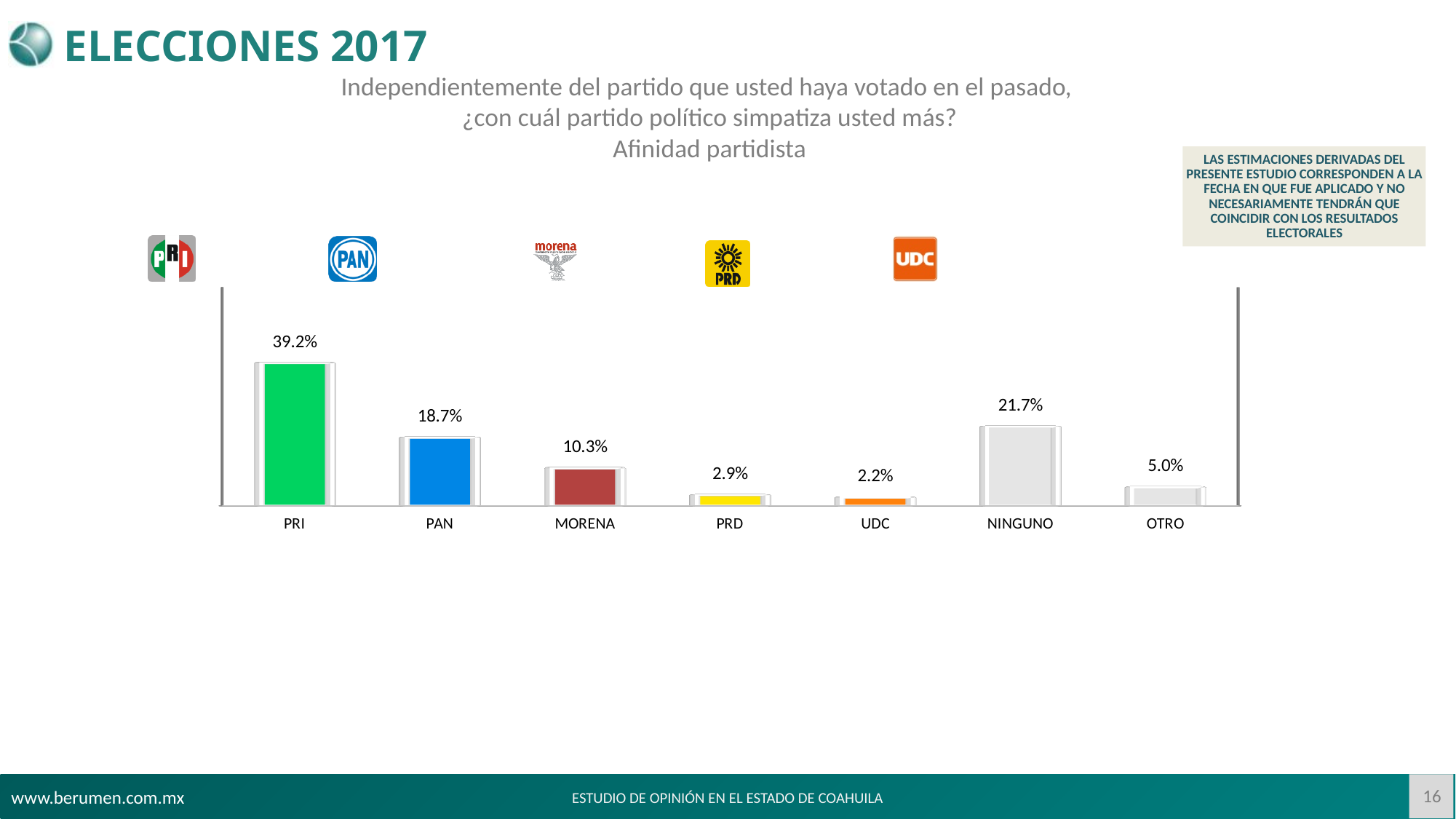
Which category has the lowest value? UDC What is the value for UDC? 2.2% How many categories are shown on the x axis? 7 What is the value shown for NINGUNO? 21.7% Which is larger, the value for PAN or the value for NINGUNO? NINGUNO Which category has the highest value? PRI What is the difference between the values for NINGUNO and OTRO? 16.7% Which is larger, the value for PRD or the value for OTRO? OTRO What percentage of respondents sympathize most with PRI? 39.2% What is the difference between the values for PRI and PAN? 20.5% What percentage is shown for MORENA? 10.3% What kind of chart is shown on the slide? Bar chart